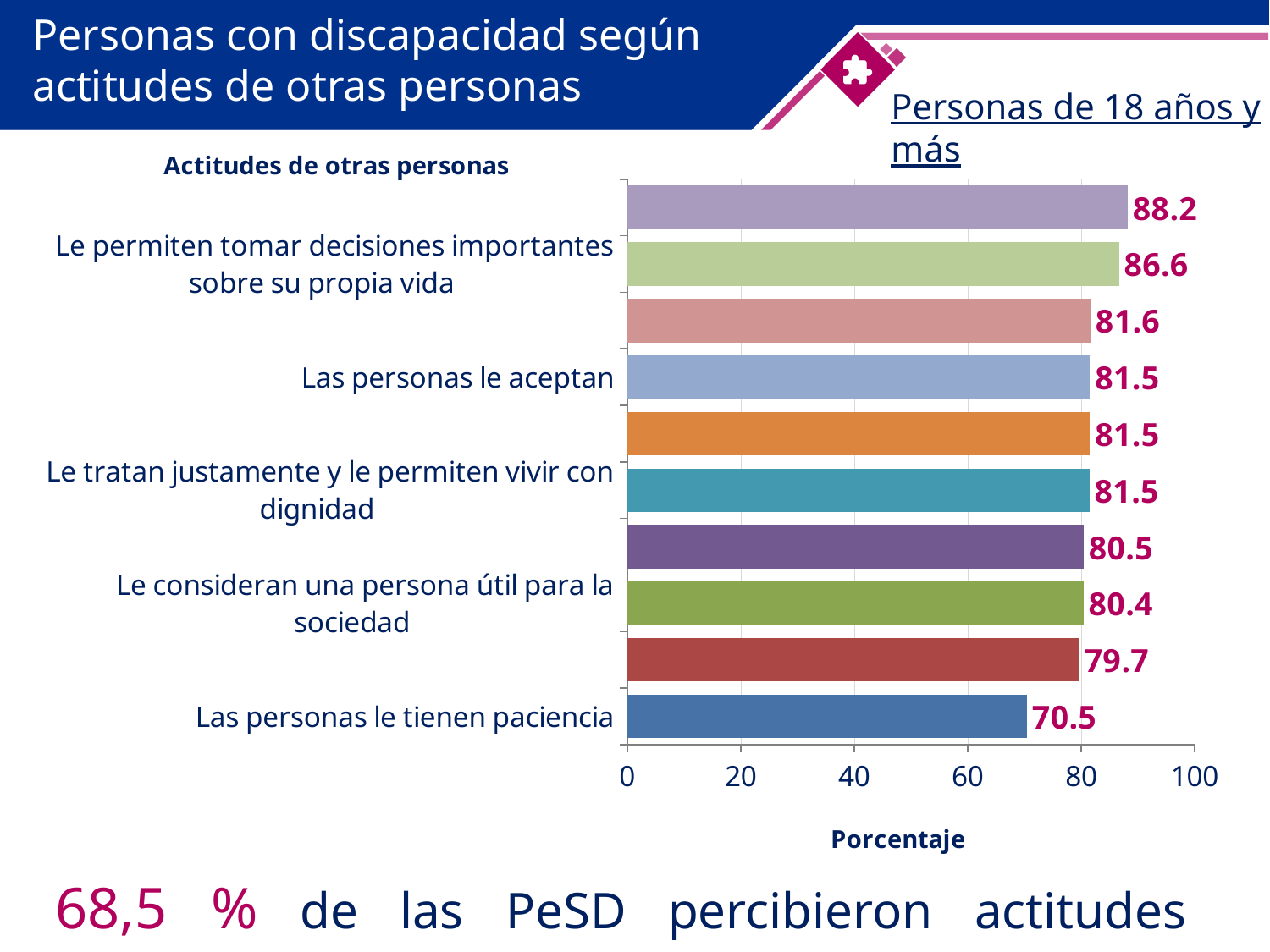
What kind of chart is shown on the slide? Bar chart What is the difference between the values for "Le permiten tomar decisiones importantes sobre su propia vida" and "Las personas le tienen paciencia"? 16.1 What is the value for "Las personas le tienen paciencia"? 70.5 Which is larger: the value for "Las personas le aceptan" or the value for "Le consideran una persona útil para la sociedad"? Las personas le aceptan What is the title of the horizontal axis of the chart? Porcentaje Which category has the lowest value in the chart? Las personas le tienen paciencia What is the value for "Le consideran una persona útil para la sociedad"? 80.4 What is the value for "Le permiten tomar decisiones importantes sobre su propia vida"? 86.6 What is the value for "Las personas le aceptan"? 81.5 What is the highest value shown in the chart? 88.2 What is the value for "Le tratan justamente y le permiten vivir con dignidad"? 81.5 How many bars are plotted in the chart? 10